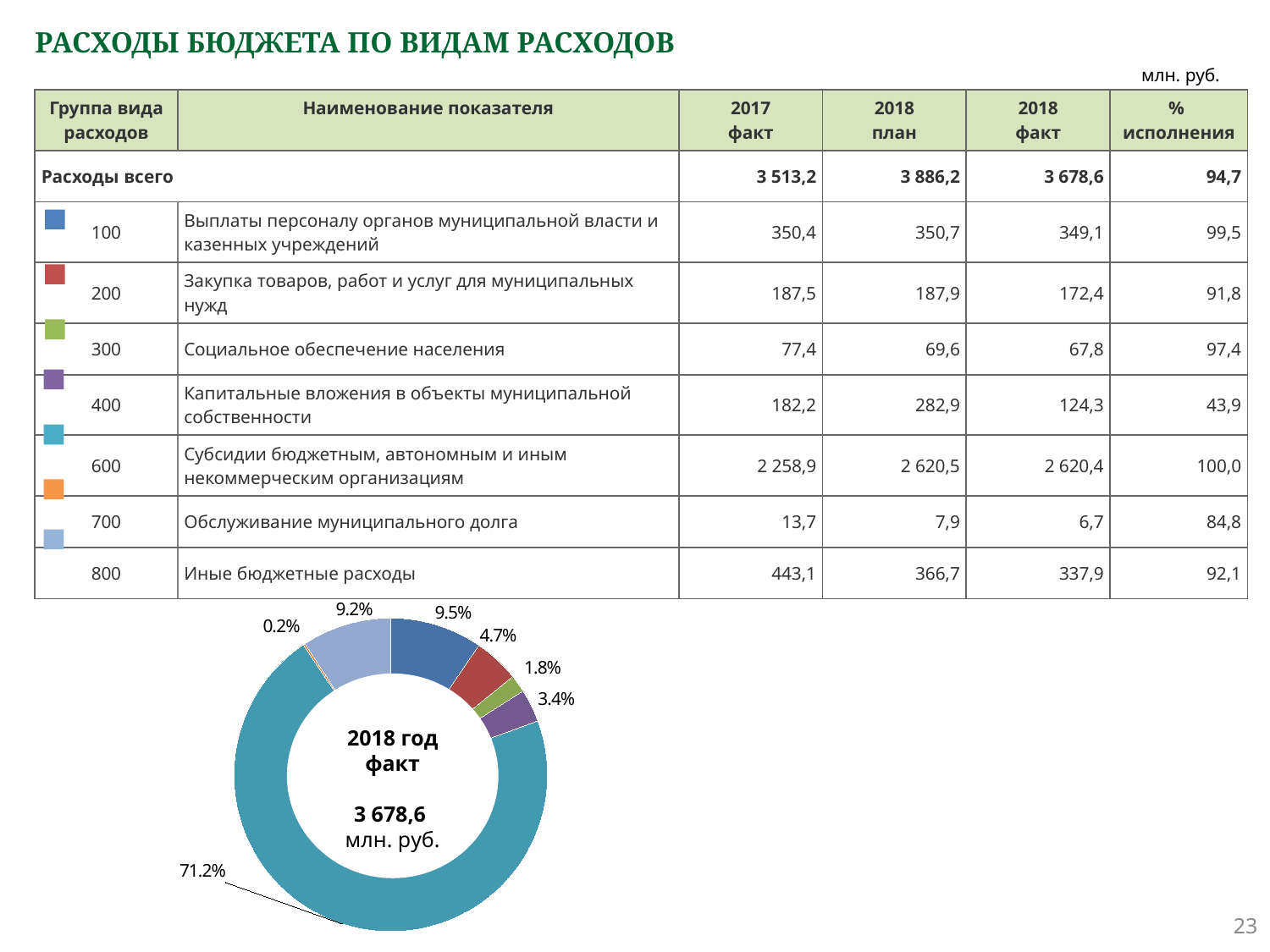
How many slices does the donut chart have? 7 What share does the light blue-grey slice of the donut chart represent? 9.2% What total value is printed in the centre of the donut chart? 3 678,6 млн. руб. Which is larger on the donut chart: the dark blue slice (9.5%) or the light blue-grey slice (9.2%)? The dark blue slice (9.5%) What is the difference between the 9.5% slice and the 4.7% slice on the donut chart? 4.8% What is the smallest share shown on the donut chart? 0.2% What share does the red slice of the donut chart represent? 4.7% What share does the purple slice of the donut chart represent? 3.4% What is the largest share shown on the donut chart? 71.2% What share does the dark blue slice of the donut chart represent? 9.5% What kind of chart is shown at the bottom of the slide? Pie (donut) chart Which year and type of data does the donut chart represent, according to its centre label? 2018 год факт